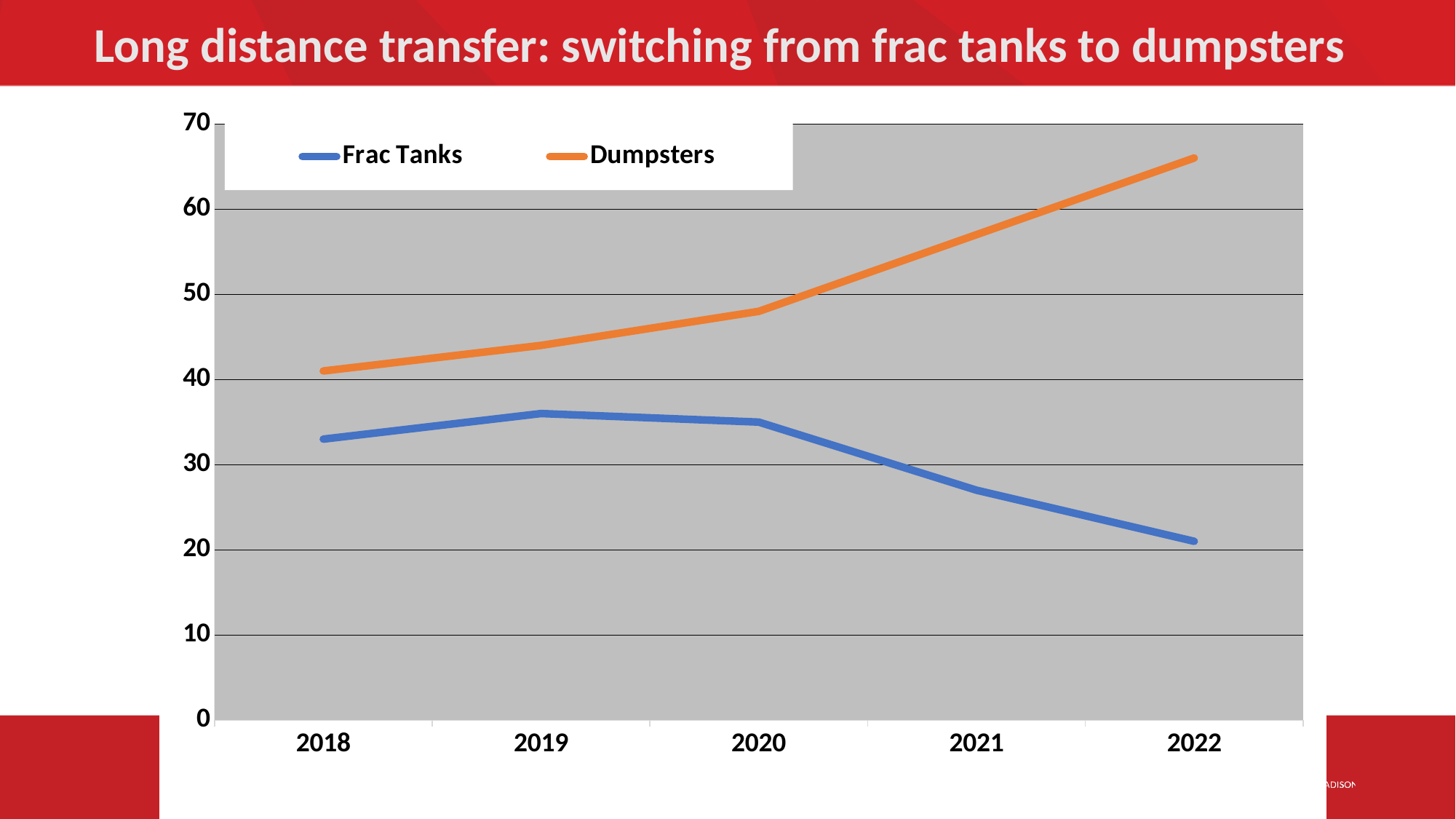
What kind of chart is shown on the slide? line chart How many years are shown on the x axis? 5 How many series does the legend list? 2 Is the value for Dumpsters in 2021 greater or less than 50? greater Is the value for Frac Tanks in 2018 greater or less than 30? greater Is the value for Frac Tanks in 2022 greater or less than 30? less In which year is the Frac Tanks value lowest? 2022 What colour is the Dumpsters line? orange In which year is the Dumpsters value highest? 2022 Do the Dumpsters values rise or fall from 2018 to 2022? rise In 2022, which series has the higher value, Frac Tanks or Dumpsters? Dumpsters